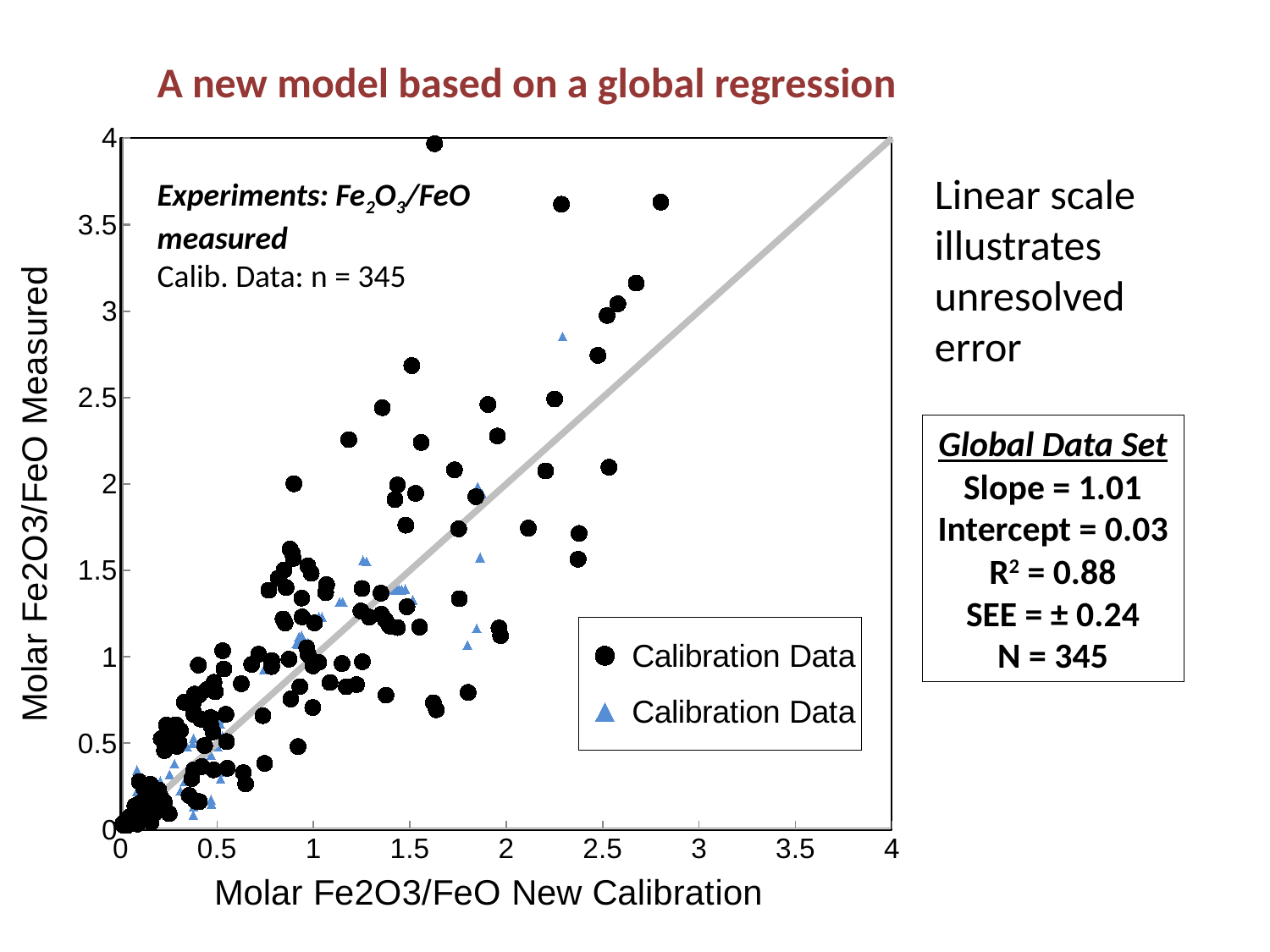
Is the highest plotted y value on the chart greater or less than 3.5? greater What kind of chart is shown on the slide? scatter chart What is the title of the x axis of the chart? Molar Fe2O3/FeO New Calibration Do the plotted points generally rise or fall as the x value increases? rise Is the largest x value among the plotted points greater or less than 3? less What is the title of the y axis of the chart? Molar Fe2O3/FeO Measured How many series does the chart legend list? 2 How many tick labels are shown on the x axis of the chart? 9